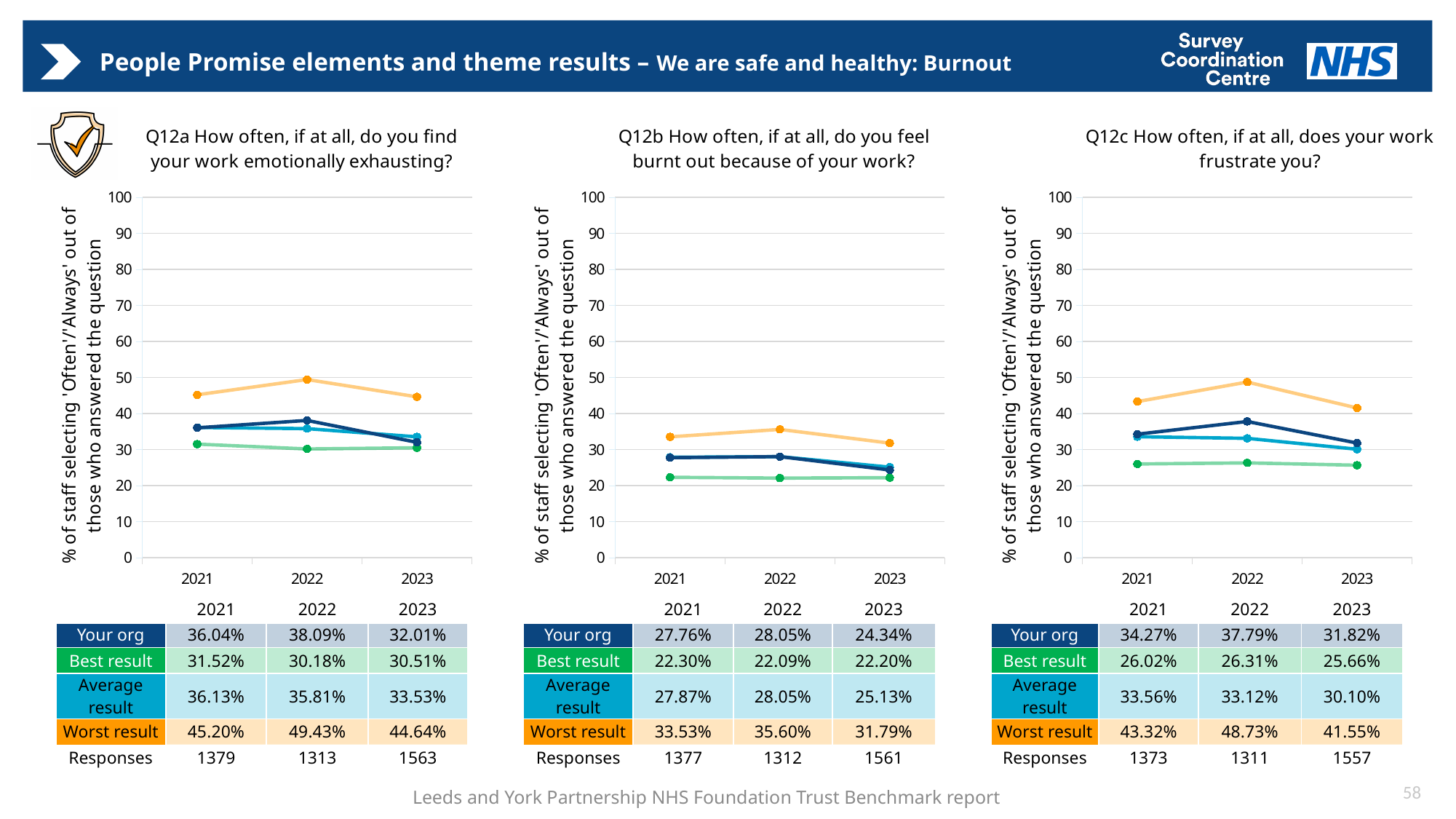
In the Q12c chart (work frustrate you), what is the 'Average result' value for 2021? 33.56% In the Q12b chart (burnt out), what is the 'Worst result' value for 2023? 31.79% In the Q12c chart (work frustrate you), which is larger in 2022: 'Your org' or 'Average result'? Your org How many years are plotted on the x axis of the Q12b chart (burnt out)? 3 In the Q12b chart (burnt out), what is the difference between the 'Your org' values for 2022 and 2023? 3.71% In the Q12a chart (emotionally exhausting), what is the 'Your org' value for 2022? 38.09% In the Q12a chart (emotionally exhausting), which year has the highest 'Worst result' value? 2022 In the Q12c chart (work frustrate you), which year has the lowest 'Your org' value? 2023 In the Q12a chart (emotionally exhausting), is the 'Worst result' value for 2022 greater or less than 40? greater In the Q12b chart (burnt out), does the 'Your org' value rise or fall from 2022 to 2023? Fall What type of chart is used for Q12a (emotionally exhausting)? Line chart How many series are plotted in the Q12c chart (work frustrate you)? 4